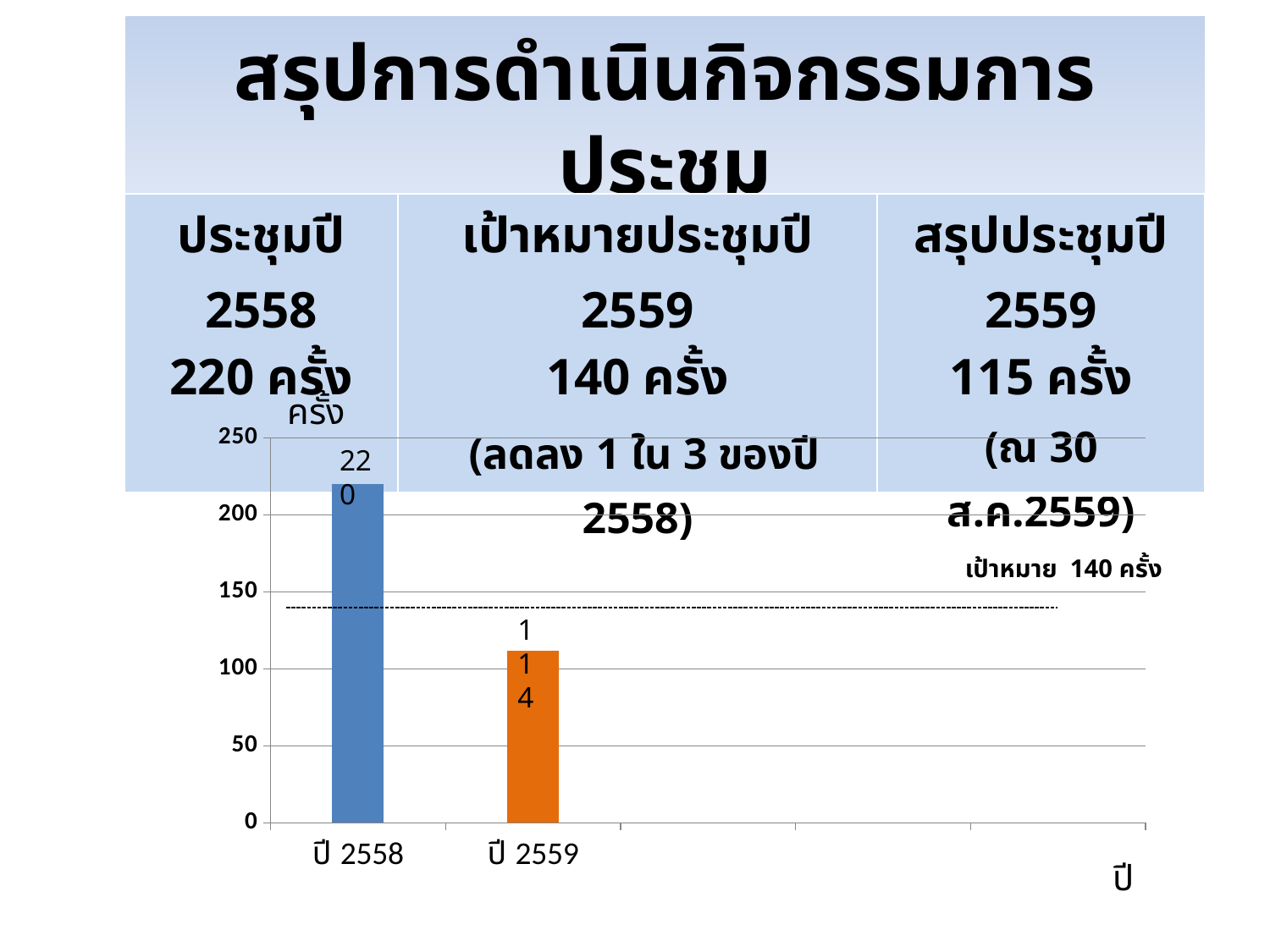
Which year has the lowest bar? ปี 2559 What is the value of the bar for ปี 2559? 114 What kind of chart is shown on the slide? bar chart Which year has the highest bar? ปี 2558 Is the value for ปี 2559 greater or less than 150? less How many bars are plotted in the chart? 2 What is the difference between the values for ปี 2558 and ปี 2559? 106 Do the values rise or fall from ปี 2558 to ปี 2559? fall Which is larger, the value for ปี 2558 or the value for ปี 2559? ปี 2558 Is the value for ปี 2558 greater or less than 200? greater What target value (เป้าหมาย) is marked by the dashed line on the chart? 140 ครั้ง What is the value of the bar for ปี 2558? 220